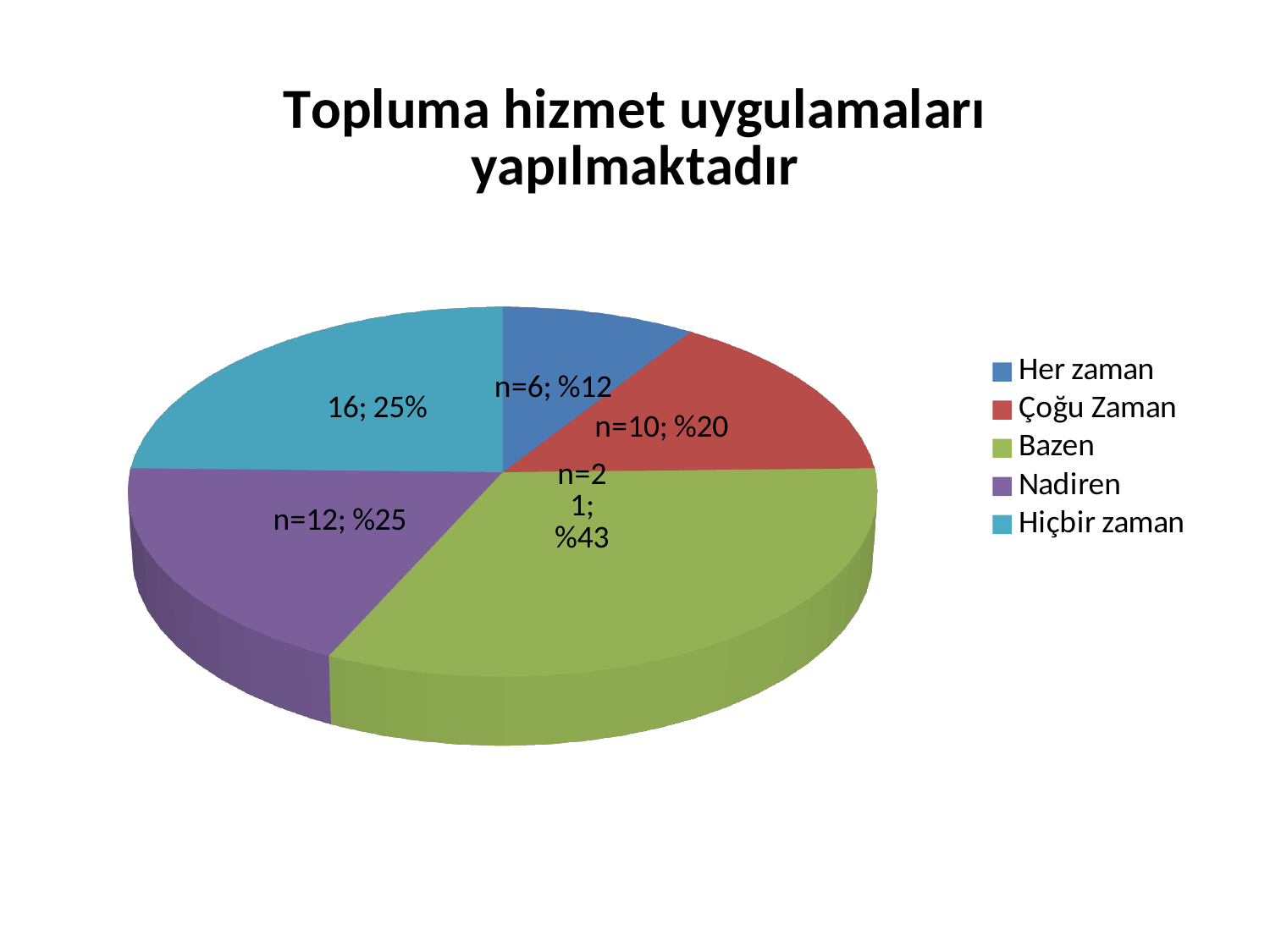
Which slice is larger, 'Nadiren' or 'Hiçbir zaman'? Hiçbir zaman What is the difference between the n values of 'Nadiren' and 'Her zaman'? 6 Which category has the largest slice of the pie? Bazen What kind of chart is shown on the slide? pie chart What percentage is shown for the 'Bazen' slice? %43 What is the title of the chart? Topluma hizmet uygulamaları yapılmaktadır What is the n value shown for the 'Her zaman' slice? n=6 What count is shown for the 'Hiçbir zaman' slice? 16 How many slices does the pie chart have? 5 What percentage is shown for the 'Çoğu Zaman' slice? %20 What is the n value shown for the 'Nadiren' slice? n=12 Which category has the smallest slice of the pie? Her zaman